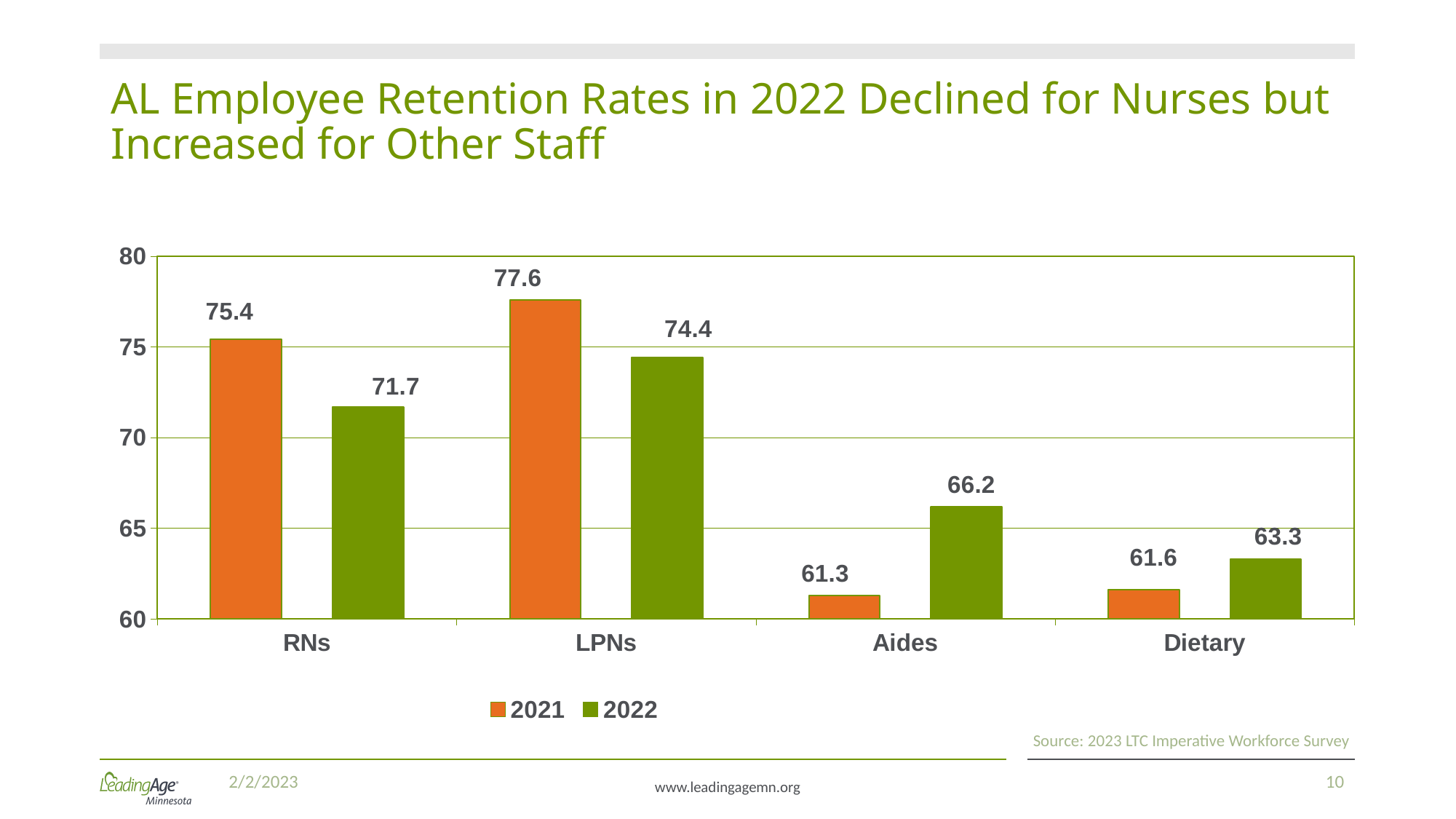
Which is larger: the 2022 retention rate for Aides or for Dietary staff? Aides By how much did the retention rate for LPNs change from 2021 to 2022? 3.2 What was the retention rate for Dietary staff in 2021? 61.6 Which staff category had the highest retention rate in 2021? LPNs What kind of chart is shown on the slide? Bar chart Is the 2022 retention rate for RNs greater or less than 75? less What was the retention rate for Aides in 2022? 66.2 How many staff categories are shown on the x axis? 4 How many series does the legend list? 2 What was the retention rate for RNs in 2021? 75.4 What is the difference between the 2022 retention rates for RNs and Aides? 5.5 Which staff category had the lowest retention rate in 2022? Dietary